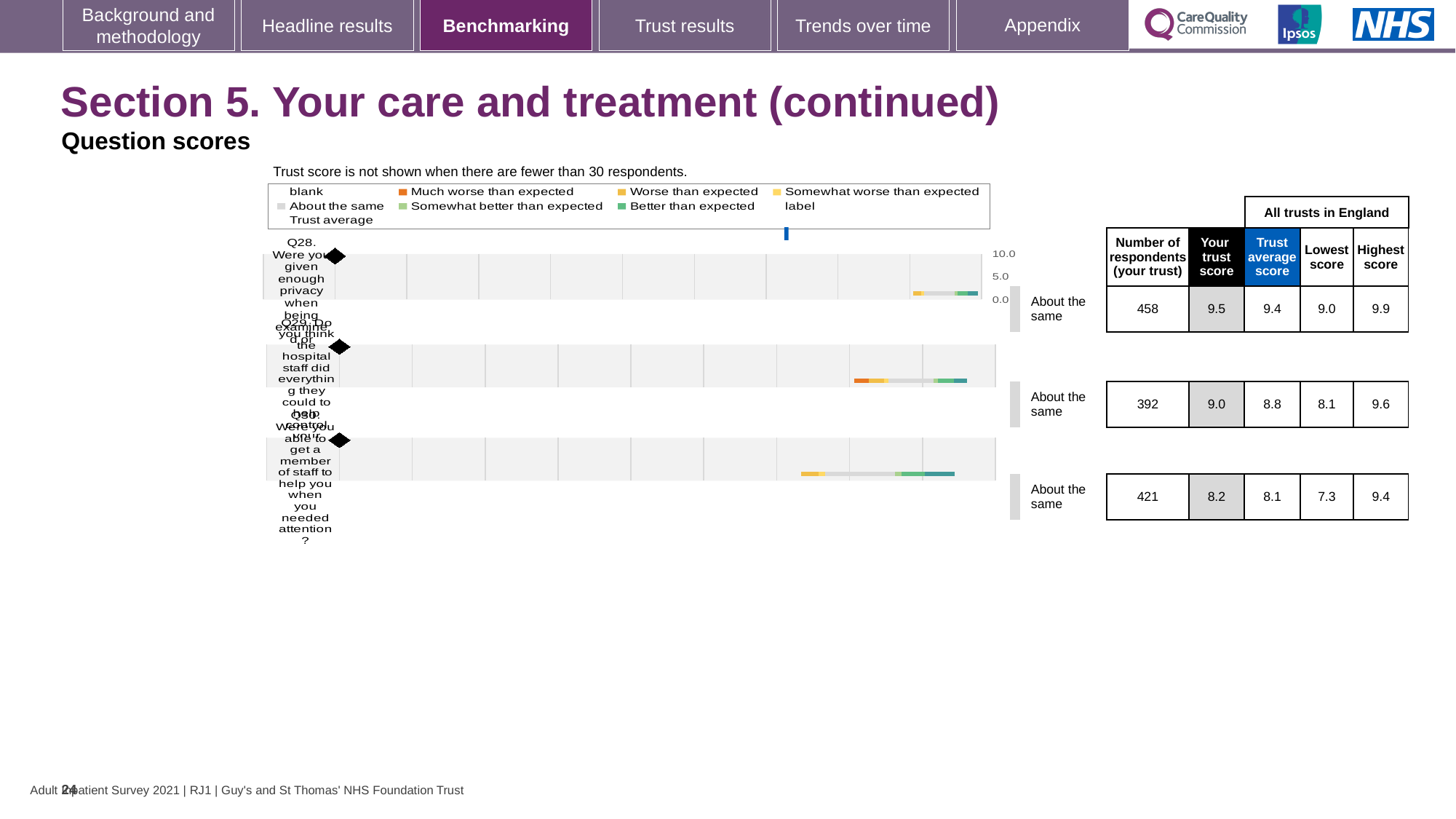
What kind of chart is used to show the question scores? Bar chart What benchmark category is shown for Q30? About the same What is the difference between the trust score and the trust average score for Q28? 0.1 For Q29, which is larger: the trust score or the trust average score? Trust score Is the trust score for Q30 greater or less than 5.0? greater Which question has the lowest trust score on this slide? Q30 What is the trust average score for Q29? 8.8 How many respondents answered Q29 (Do you think the hospital staff did everything they could to help control your pain)? 392 What is the highest score across all trusts in England for Q30 (Were you able to get a member of staff to help you when you needed attention)? 9.4 What is the trust score for Q28 (Were you given enough privacy when being examined or treated)? 9.5 Which question has the highest trust score on this slide? Q28 How many questions are charted on this slide? 3